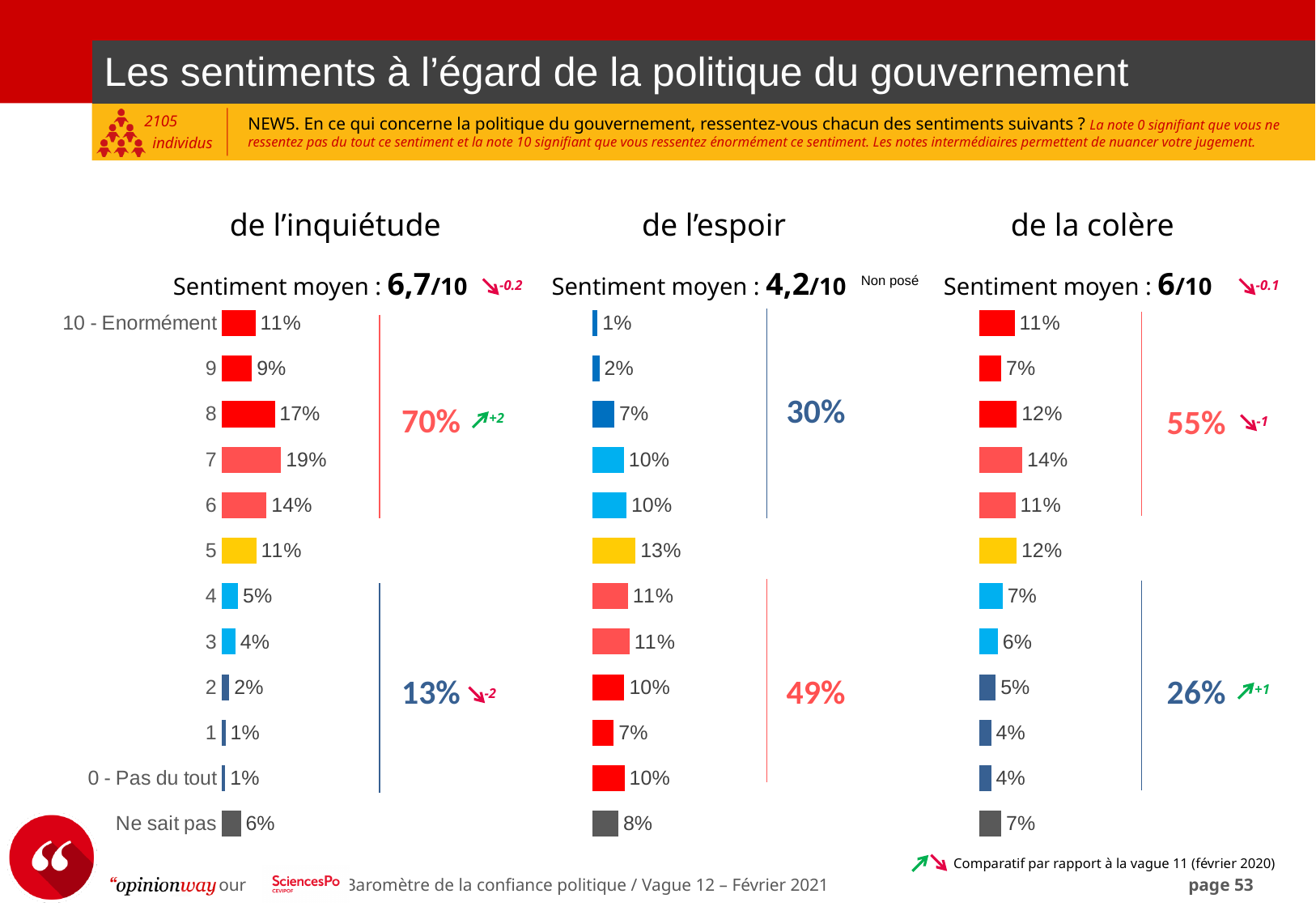
In the 'de l'espoir' chart, which is larger: the percentage for score 8 or the percentage for score 2? score 2 In the 'de la colère' chart, what is the difference between the percentage for score 7 and the percentage for score 3? 8% What kind of chart is used to show the 'de l'espoir' results? bar chart How many categories (including 'Ne sait pas') are shown in the 'de l'inquiétude' chart? 12 What is the 'Sentiment moyen' shown above the 'de la colère' chart? 6/10 In the 'de l'inquiétude' chart, what is the difference between the percentage for score 8 and the percentage for score 9? 8% In the 'de l'inquiétude' chart, what percentage of respondents gave a score of 7? 19% In the 'de l'inquiétude' chart, which score has the highest percentage? 7 In the 'de l'espoir' chart, which score has the lowest percentage? 10 - Enormément In the 'de la colère' chart, what percentage of respondents answered '10 - Enormément'? 11% In the 'de l'espoir' chart, what percentage of respondents gave a score of 5? 13% In the 'de la colère' chart, which score has the highest percentage? 7